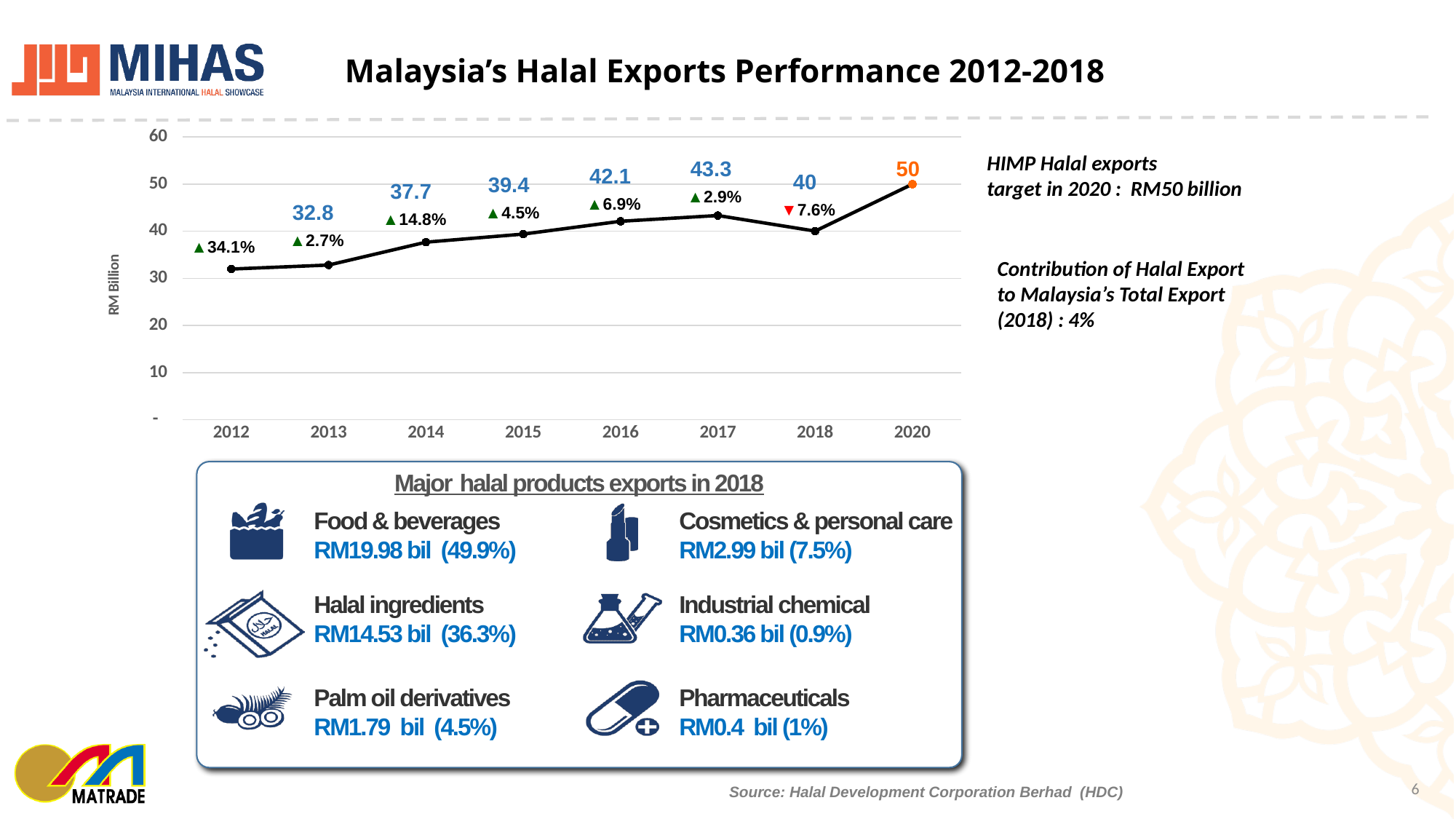
Is the value for 2012 greater or less than 40? less What is the difference between the plotted values for 2017 and 2018? 3.3 Which year has the lowest plotted value among those with a printed value label in the line chart? 2013 Which is larger, the plotted value for 2016 or for 2015? 2016 What is the value plotted for 2017 in the line chart? 43.3 What is the value plotted for 2018 in the line chart? 40 What kind of chart is shown on the slide? line chart What is the label on the y axis of the line chart? RM Billion Which year has the highest plotted value in the line chart? 2020 How many years are shown on the x axis of the line chart? 8 What is the value plotted for 2014 in the line chart? 37.7 What percentage change is labelled for 2018 in the line chart? ▼7.6%